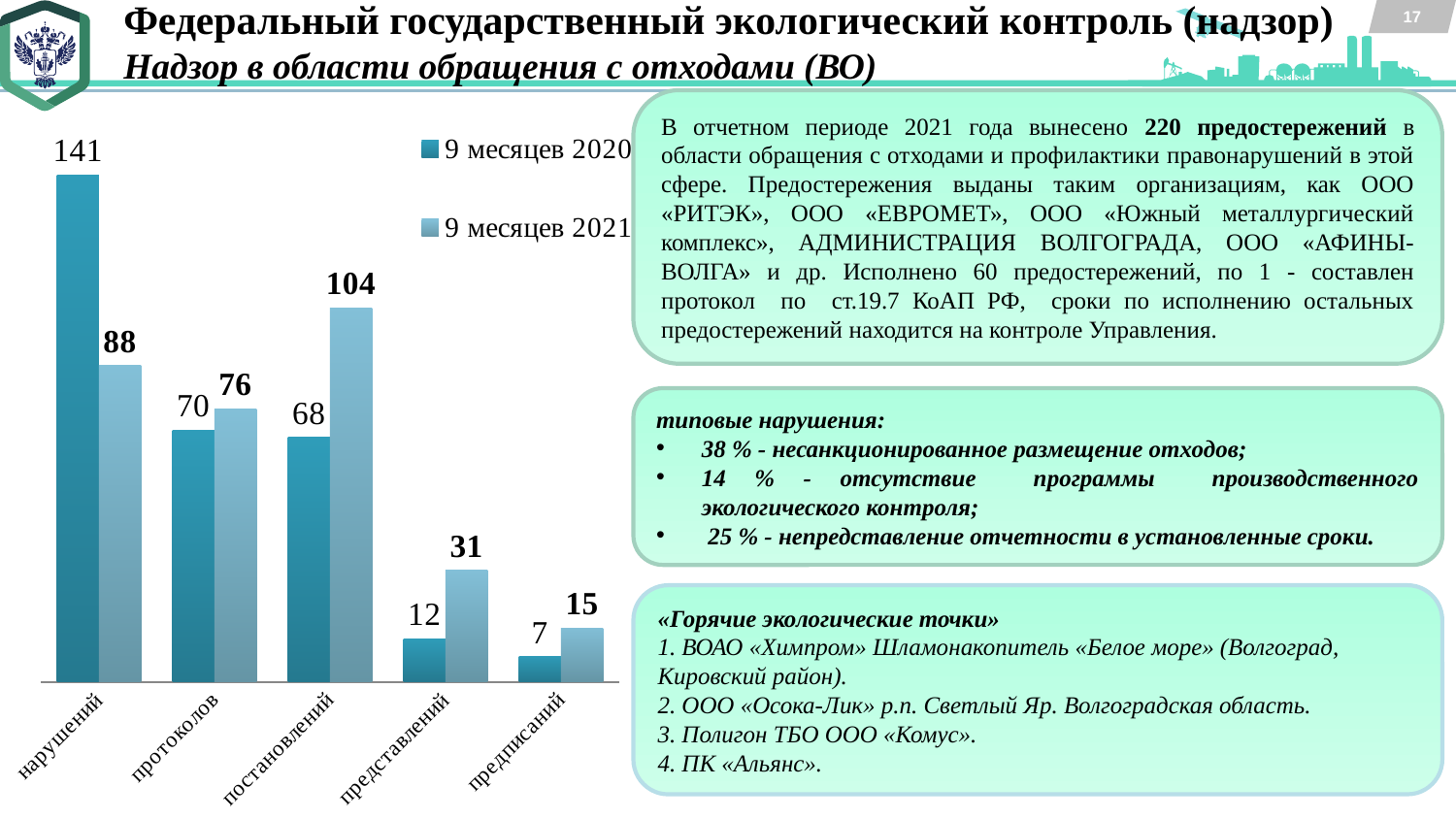
Which category has the lowest value in the series 9 месяцев 2021? предписаний How many categories are shown on the x axis of the chart? 5 What is the value for постановлений in the series 9 месяцев 2021? 104 What is the difference between the 9 месяцев 2021 and 9 месяцев 2020 values for представлений? 19 What is the value for нарушений in the series 9 месяцев 2020? 141 Which category has the highest value in the series 9 месяцев 2020? нарушений What is the difference between the 9 месяцев 2020 and 9 месяцев 2021 values for нарушений? 53 What are the two series names listed in the chart legend? 9 месяцев 2020 and 9 месяцев 2021 What type of chart is shown on the slide? bar chart For протоколов, which series has the larger value: 9 месяцев 2020 or 9 месяцев 2021? 9 месяцев 2021 What is the value for представлений in the series 9 месяцев 2020? 12 How many series does the chart legend list? 2